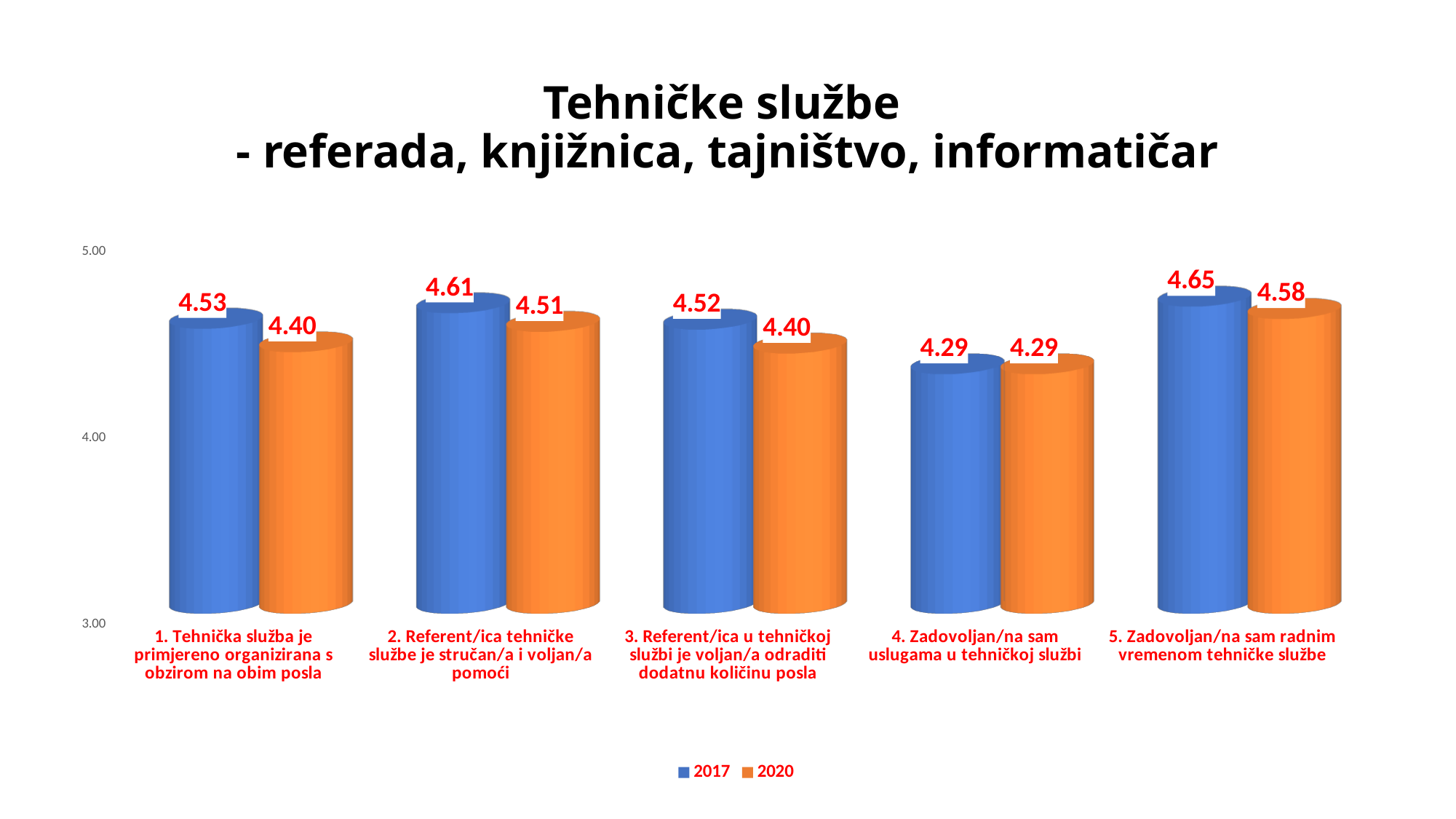
How many series does the legend list? 2 What is the difference between the 2017 and 2020 values for category 3 (Referent/ica u tehničkoj službi je voljan/a odraditi dodatnu količinu posla)? 0.12 Which category has the highest 2017 value? 5. Zadovoljan/na sam radnim vremenom tehničke službe What is the difference between the 2017 and 2020 values for category 1 (Tehnička služba je primjereno organizirana s obzirom na obim posla)? 0.13 Which category has the lowest 2020 value? 4. Zadovoljan/na sam uslugama u tehničkoj službi What is the 2017 value for category 1 (Tehnička služba je primjereno organizirana s obzirom na obim posla)? 4.53 What is the 2020 value for category 5 (Zadovoljan/na sam radnim vremenom tehničke službe)? 4.58 What kind of chart is shown on the slide? bar chart How many categories are shown on the x axis? 5 Is the 2017 value for category 4 (Zadovoljan/na sam uslugama u tehničkoj službi) greater or less than 4.00? greater What is the 2020 value for category 3 (Referent/ica u tehničkoj službi je voljan/a odraditi dodatnu količinu posla)? 4.40 Which is larger for category 2 (Referent/ica tehničke službe je stručan/a i voljan/a pomoći): the 2017 value or the 2020 value? 2017